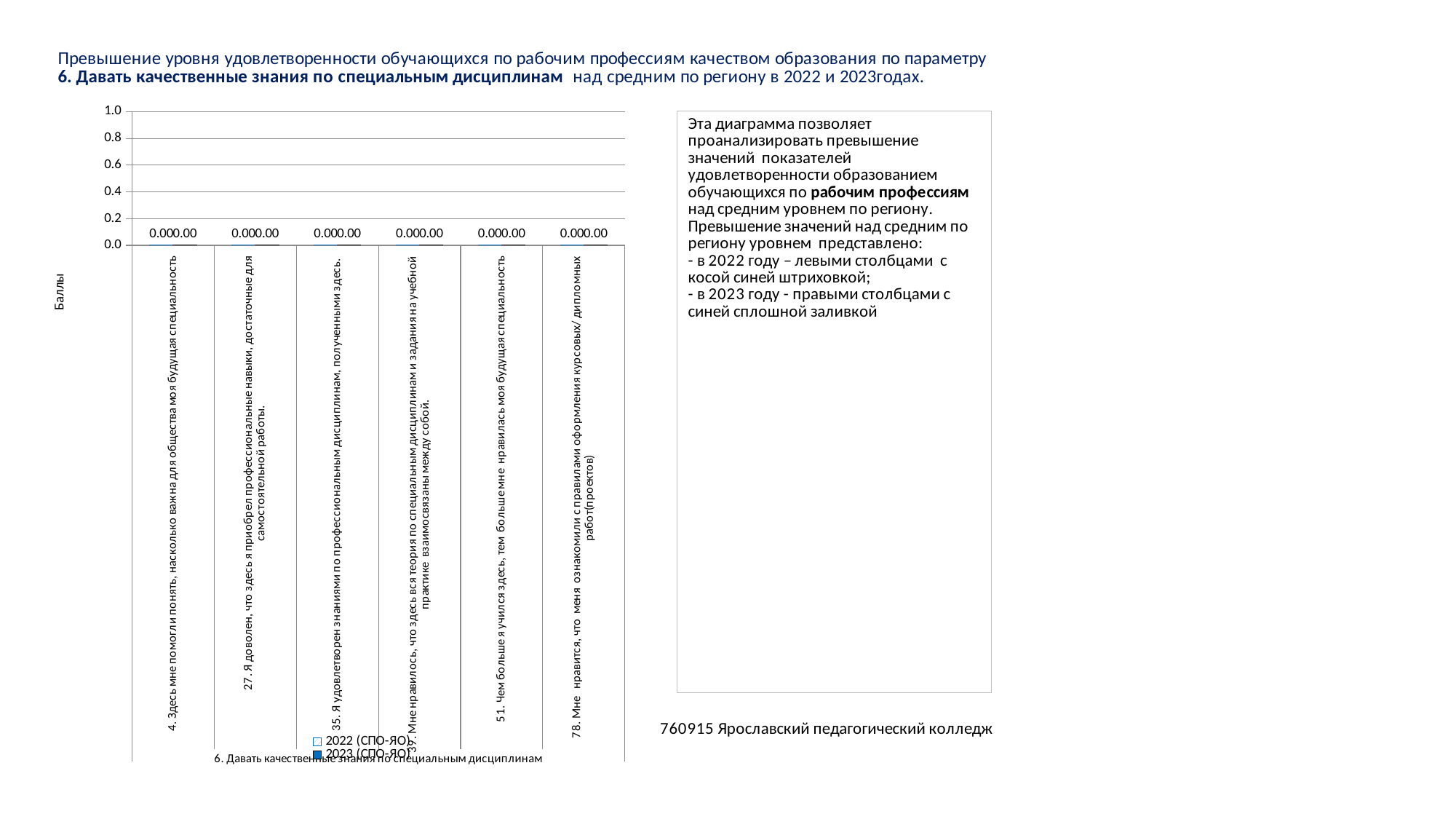
What kind of chart is shown on the slide? bar chart Is the value for category 51 (Чем больше я учился здесь, тем больше мне нравилась моя будущая специальность) greater or less than 0.4? less Is the value for category 4 (Здесь мне помогли понять, насколько важна для общества моя будущая специальность) greater or less than 0.2? less Is the value for category 78 (Мне нравится, что меня ознакомили с правилами оформления курсовых/дипломных работ(проектов)) greater or less than 0.2? less What is the highest value shown on the vertical axis of the chart? 1.0 How many categories are shown on the x axis of the chart? 6 What are the two series named in the chart legend? 2022 (СПО-ЯО) and 2023 (СПО-ЯО) How many series does the chart legend list? 2 What is the label of the vertical axis of the chart? Баллы